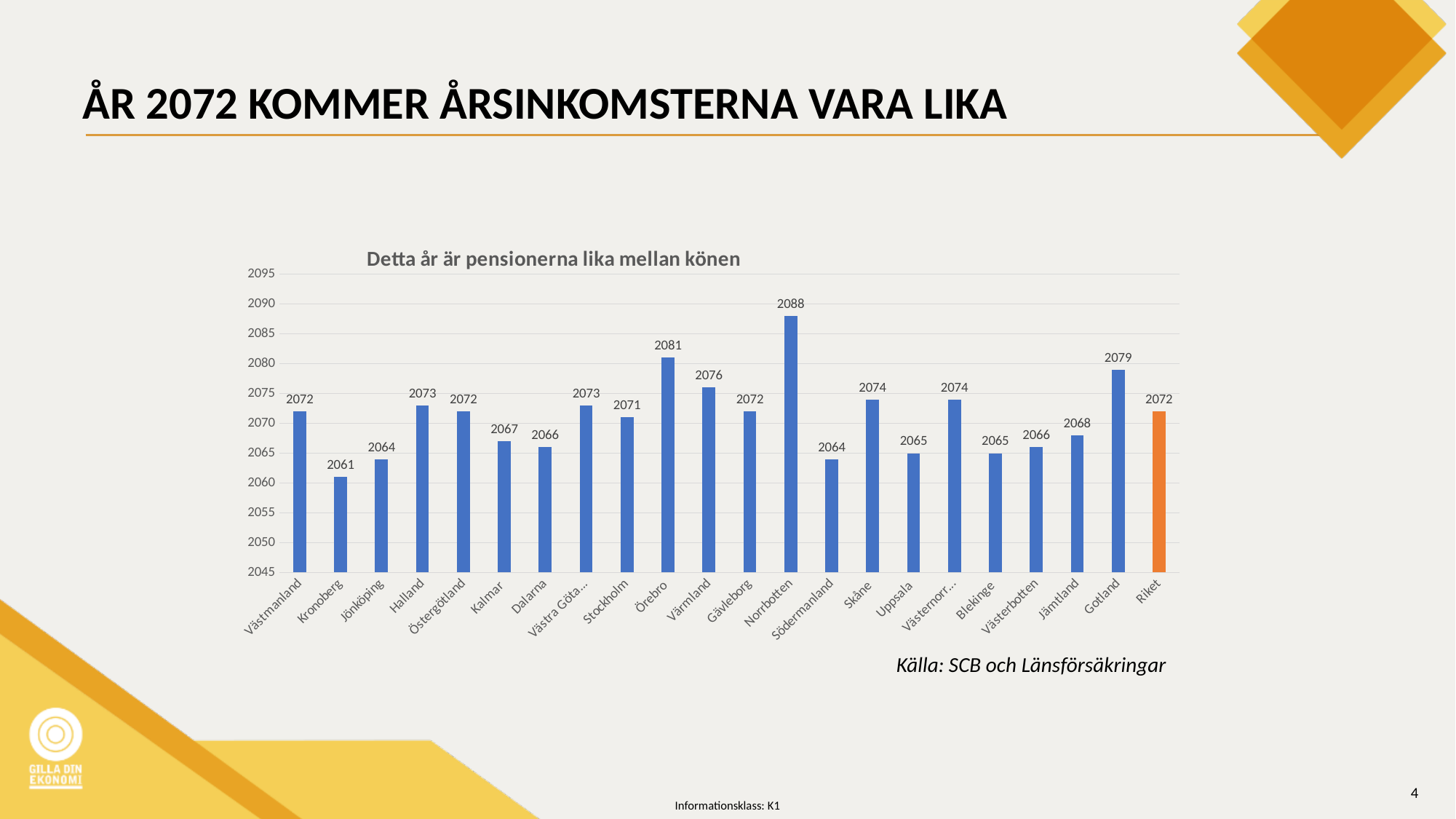
Which category has the lowest value? Kronoberg How many categories are shown on the x axis? 22 What is the value for Riket? 2072 What kind of chart is shown on the slide? Bar chart What is the value for Kronoberg? 2061 What is the difference between the values for Örebro and Stockholm? 10 What is the value for Gotland? 2079 What is the value for Norrbotten? 2088 Which category has the highest value? Norrbotten What is the difference between the values for Norrbotten and Kronoberg? 27 What is the title of the chart? Detta år är pensionerna lika mellan könen Which is larger, the value for Värmland or the value for Jämtland? Värmland